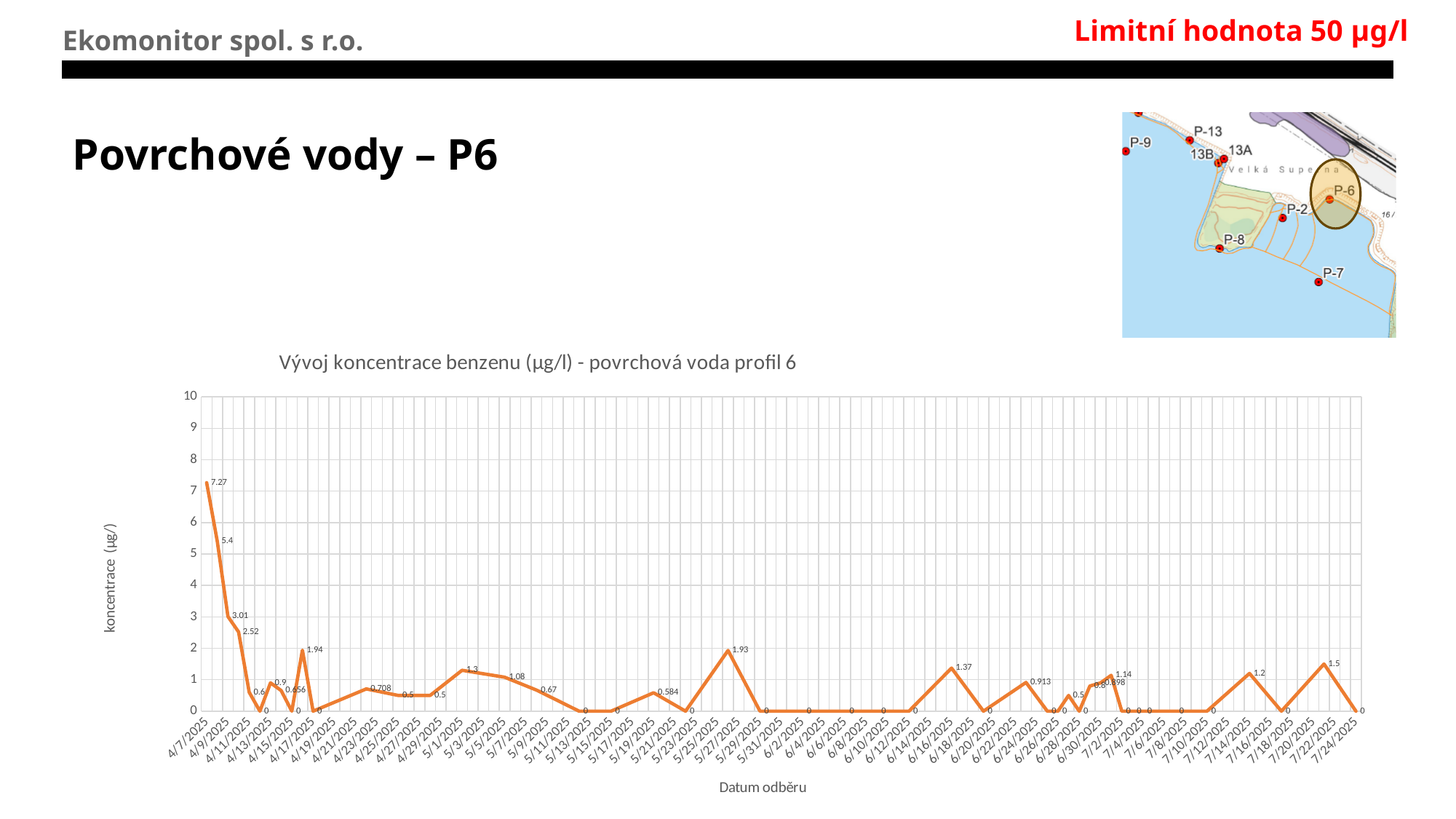
What is the difference between the first plotted value (7.27) and the second plotted value (5.4)? 1.87 Is the value for 4/7/2025 greater or less than 5? greater What is the highest value plotted on the chart? 7.27 Which is larger: the value at 4/7/2025 or the peak labelled 1.94? the value at 4/7/2025 What is the label of the x axis? Datum odběru What is the maximum value shown on the y axis? 10 What type of chart is shown on the slide? line chart What is the title of the chart? Vývoj koncentrace benzenu (µg/l) - povrchová voda profil 6 What is the lowest value plotted on the chart? 0 Is the highest value on the chart greater or less than 8? less What is the benzene concentration plotted for 4/7/2025? 7.27 Do the values rise or fall over the first few dates starting at 4/7/2025? fall